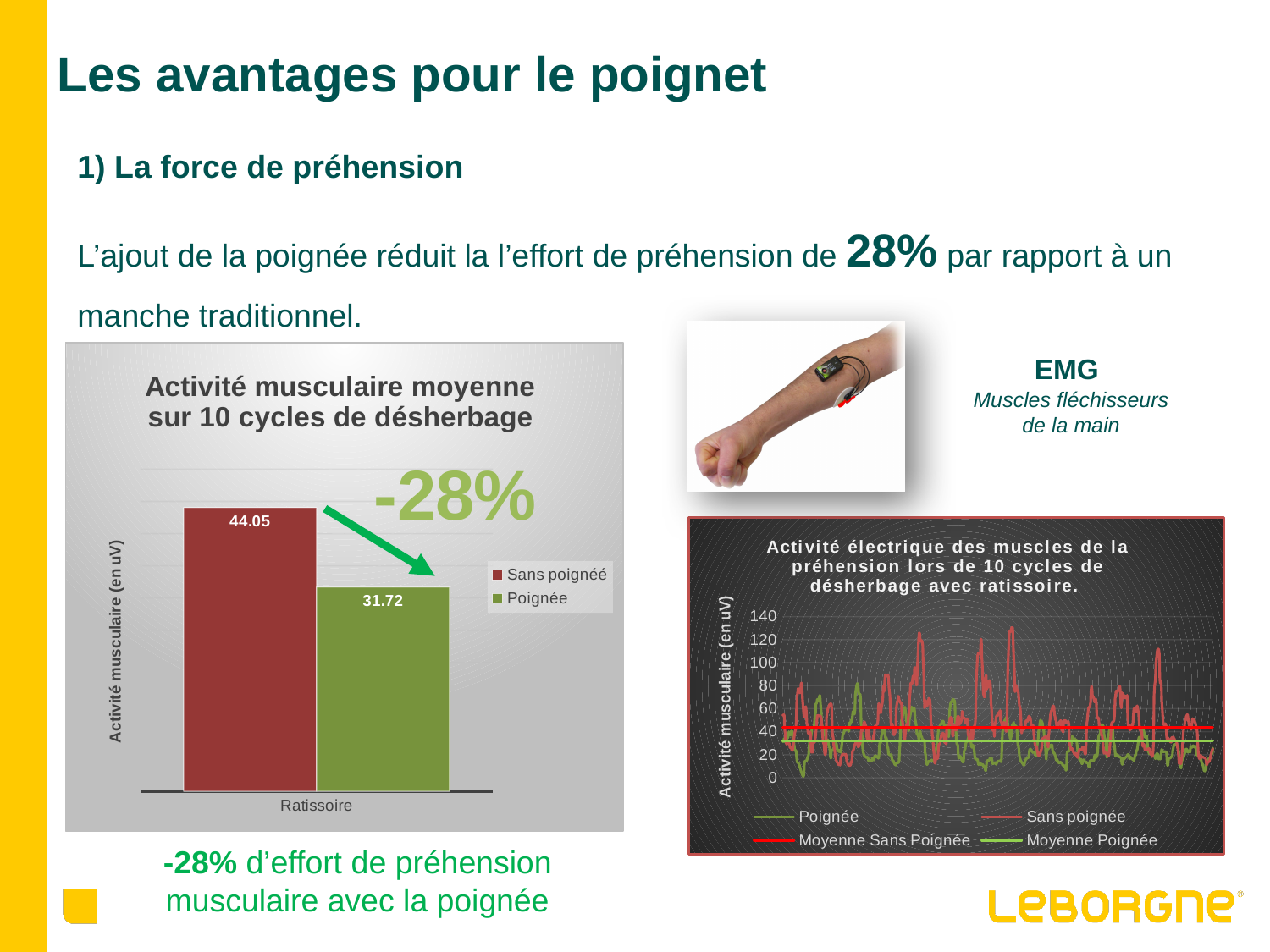
In the bar chart 'Activité musculaire moyenne sur 10 cycles de désherbage', what is the category label on the x axis? Ratissoire In the bar chart 'Activité musculaire moyenne sur 10 cycles de désherbage', which series has the lower value? Poignée What kind of chart is the chart titled 'Activité musculaire moyenne sur 10 cycles de désherbage'? Bar chart In the bar chart 'Activité musculaire moyenne sur 10 cycles de désherbage', how many series does the legend list? 2 In the chart 'Activité électrique des muscles de la préhension lors de 10 cycles de désherbage avec ratissoire.', how many series does the legend list? 4 In the chart 'Activité électrique des muscles de la préhension lors de 10 cycles de désherbage avec ratissoire.', is the 'Moyenne Sans Poignée' line greater or less than 20? greater In the bar chart 'Activité musculaire moyenne sur 10 cycles de désherbage', what is the value for 'Poignée'? 31.72 What kind of chart is the chart titled 'Activité électrique des muscles de la préhension lors de 10 cycles de désherbage avec ratissoire.'? Line chart In the bar chart 'Activité musculaire moyenne sur 10 cycles de désherbage', which series has the higher value? Sans poignéé In the bar chart 'Activité musculaire moyenne sur 10 cycles de désherbage', what is the y-axis label? Activité musculaire (en uV) In the bar chart 'Activité musculaire moyenne sur 10 cycles de désherbage', what is the difference between the 'Sans poignéé' and 'Poignée' values? 12.33 In the bar chart 'Activité musculaire moyenne sur 10 cycles de désherbage', what is the value for 'Sans poignéé'? 44.05